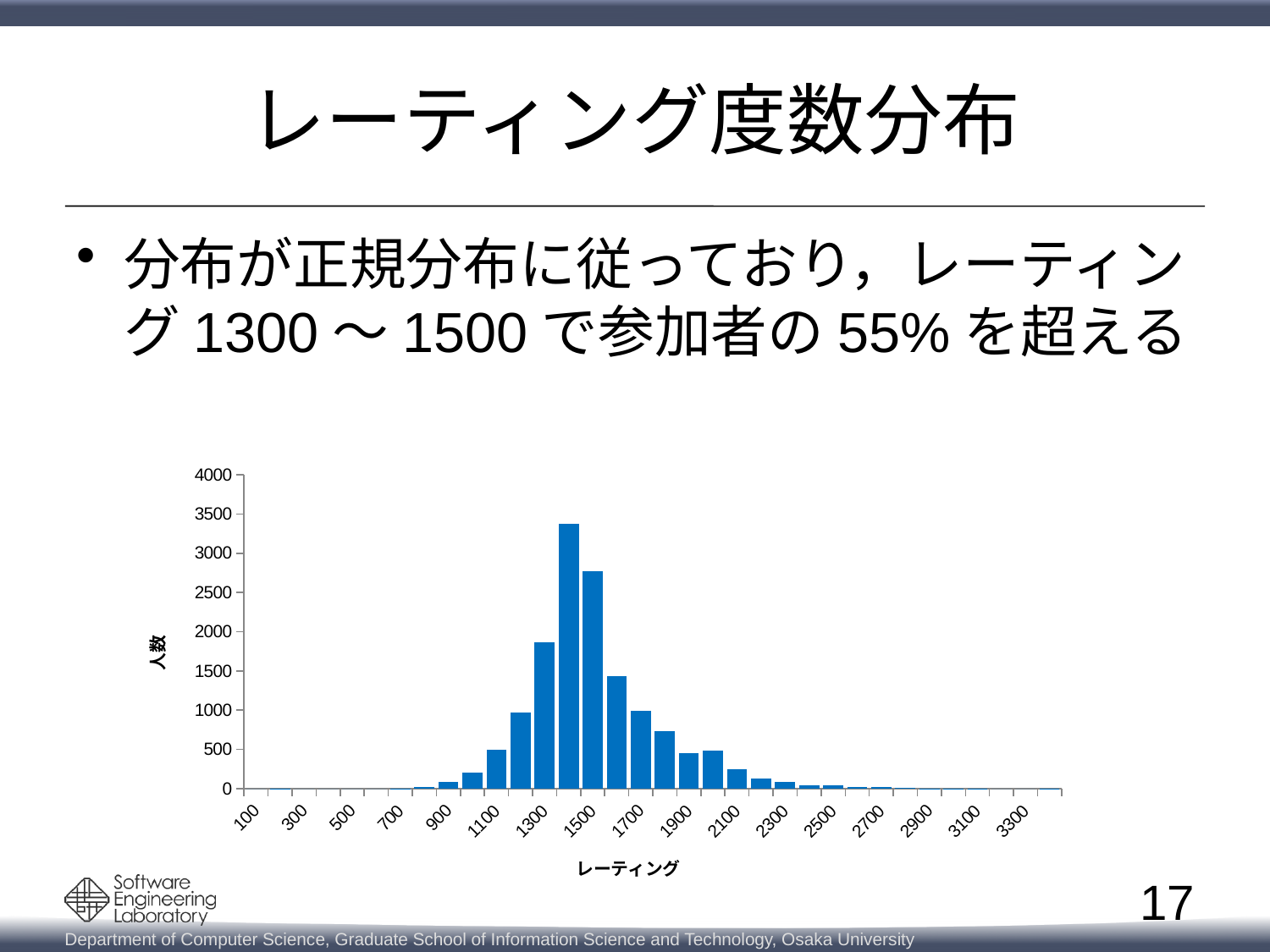
What is the title of the horizontal axis of the chart? レーティング Is the value for rating 1700 greater or less than 500? greater Which has the larger value, rating 1700 or rating 1900? 1700 What is the title of the vertical axis of the chart? 人数 Is the value for rating 2100 greater or less than 500? less What kind of chart is shown on the slide? bar chart Is the value for rating 1500 greater or less than 2500? greater How many labels are printed along the horizontal axis of the chart? 17 Which has the larger value, rating 1300 or rating 1500? 1500